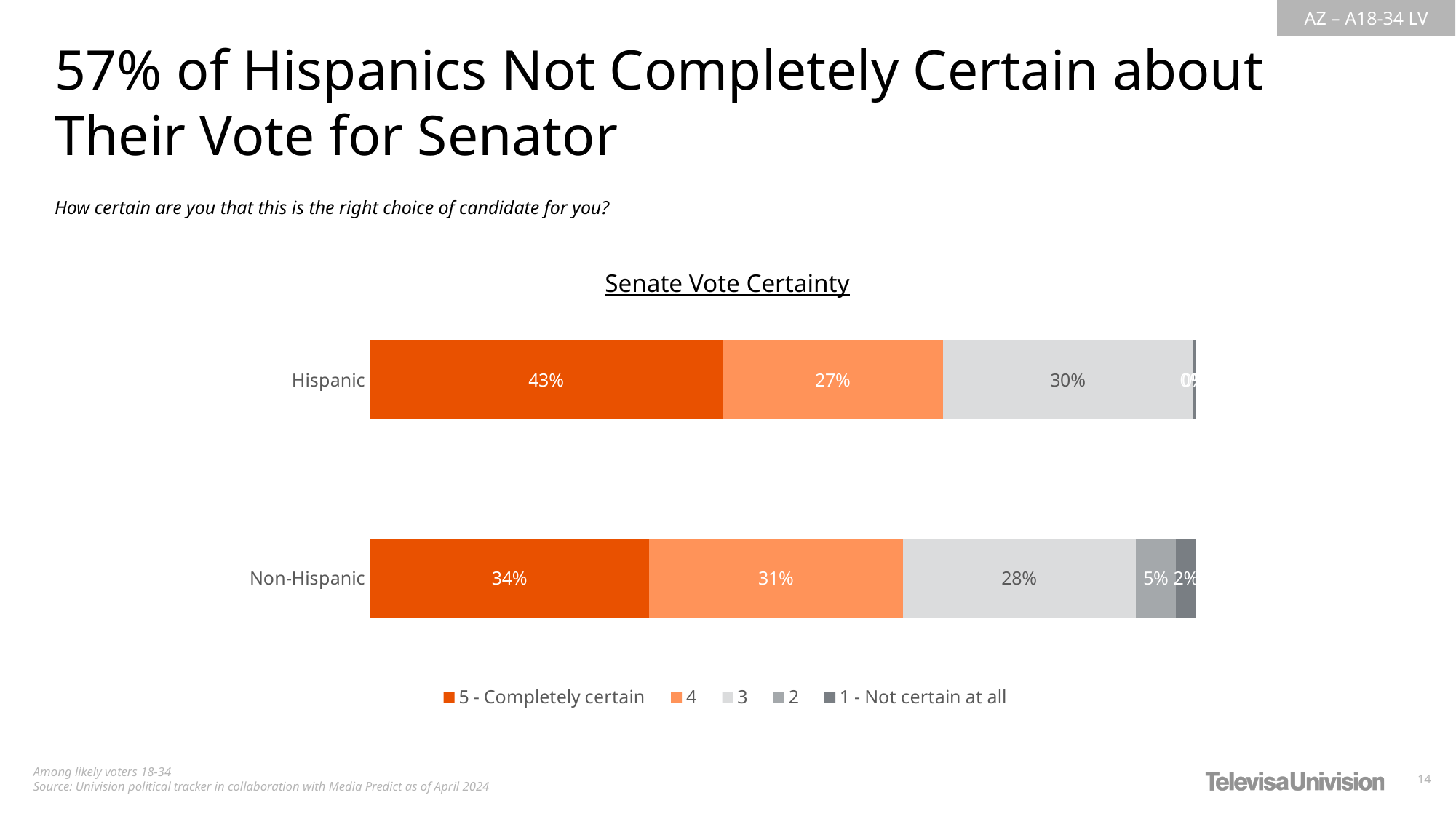
What percentage of Hispanic respondents rated their certainty as '3'? 30% Which group has the higher share of '5 - Completely certain' responses, Hispanic or Non-Hispanic? Hispanic What percentage of Hispanic respondents are '5 - Completely certain' about their Senate vote? 43% What is the difference between the Hispanic and Non-Hispanic shares of '5 - Completely certain' responses? 9 percentage points What percentage of Non-Hispanic respondents rated their certainty as '3'? 28% What kind of chart is shown on the slide? Stacked horizontal bar chart What is the difference between the Non-Hispanic and Hispanic shares of '4' responses? 4 percentage points How many groups (categories) are shown on the chart? 2 What percentage of Non-Hispanic respondents are '1 - Not certain at all'? 2% How many series does the legend list? 5 What percentage of Non-Hispanic respondents rated their certainty as '4'? 31% What is the title of the chart? Senate Vote Certainty